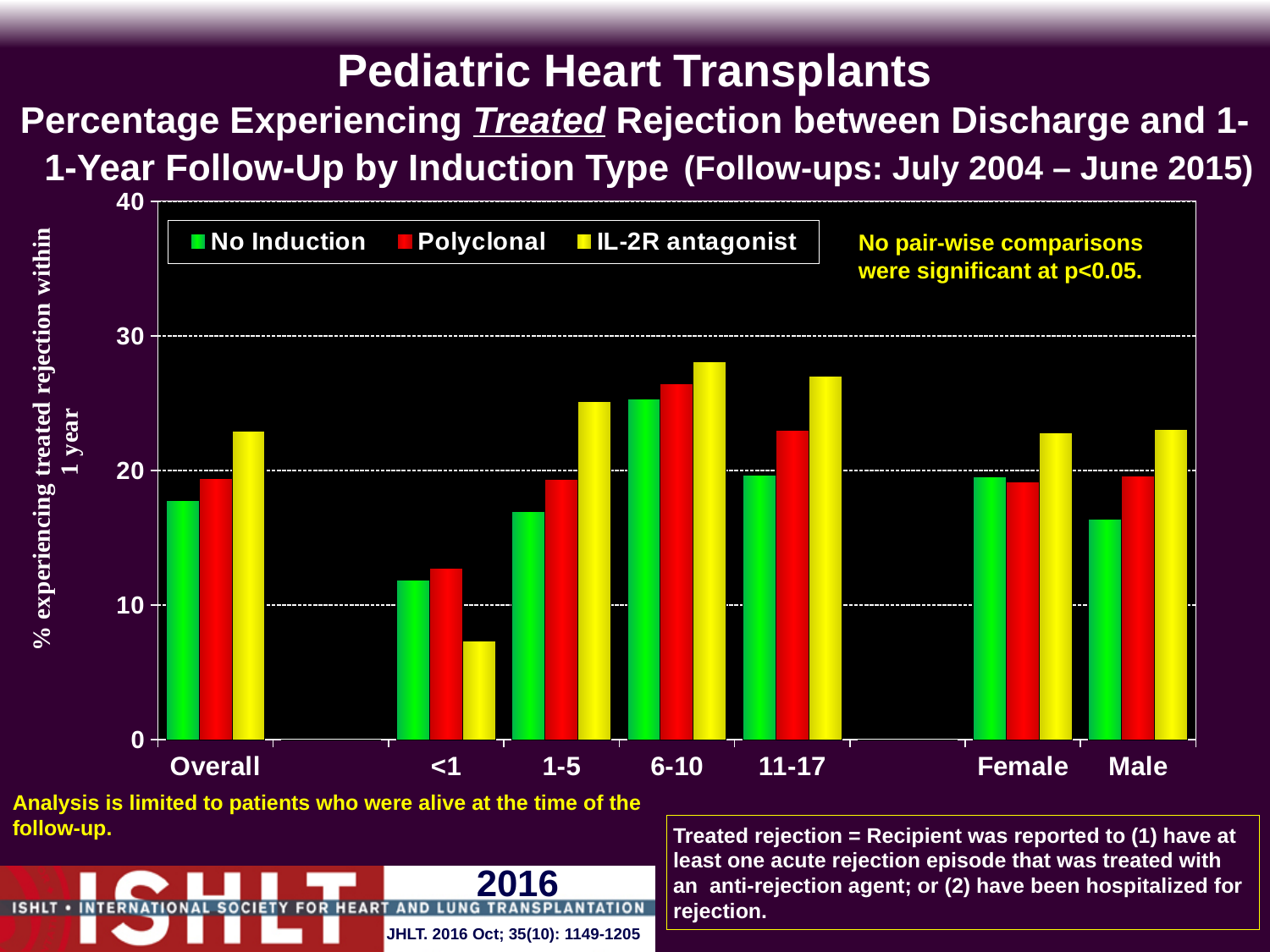
Is the value for No Induction in the 6-10 age group greater or less than 20? greater For the Overall category, which is larger: No Induction or IL-2R antagonist? IL-2R antagonist What kind of chart is shown on the slide? bar chart Is the value for IL-2R antagonist in the <1 age group greater or less than 10? less How many categories are shown along the x axis? 7 Which induction type has the highest value in the 1-5 age group? IL-2R antagonist How many series does the legend list? 3 Is the value for No Induction for Male greater or less than 20? less For the <1 age group, which is larger: No Induction or IL-2R antagonist? No Induction Which category has the lowest value for IL-2R antagonist? <1